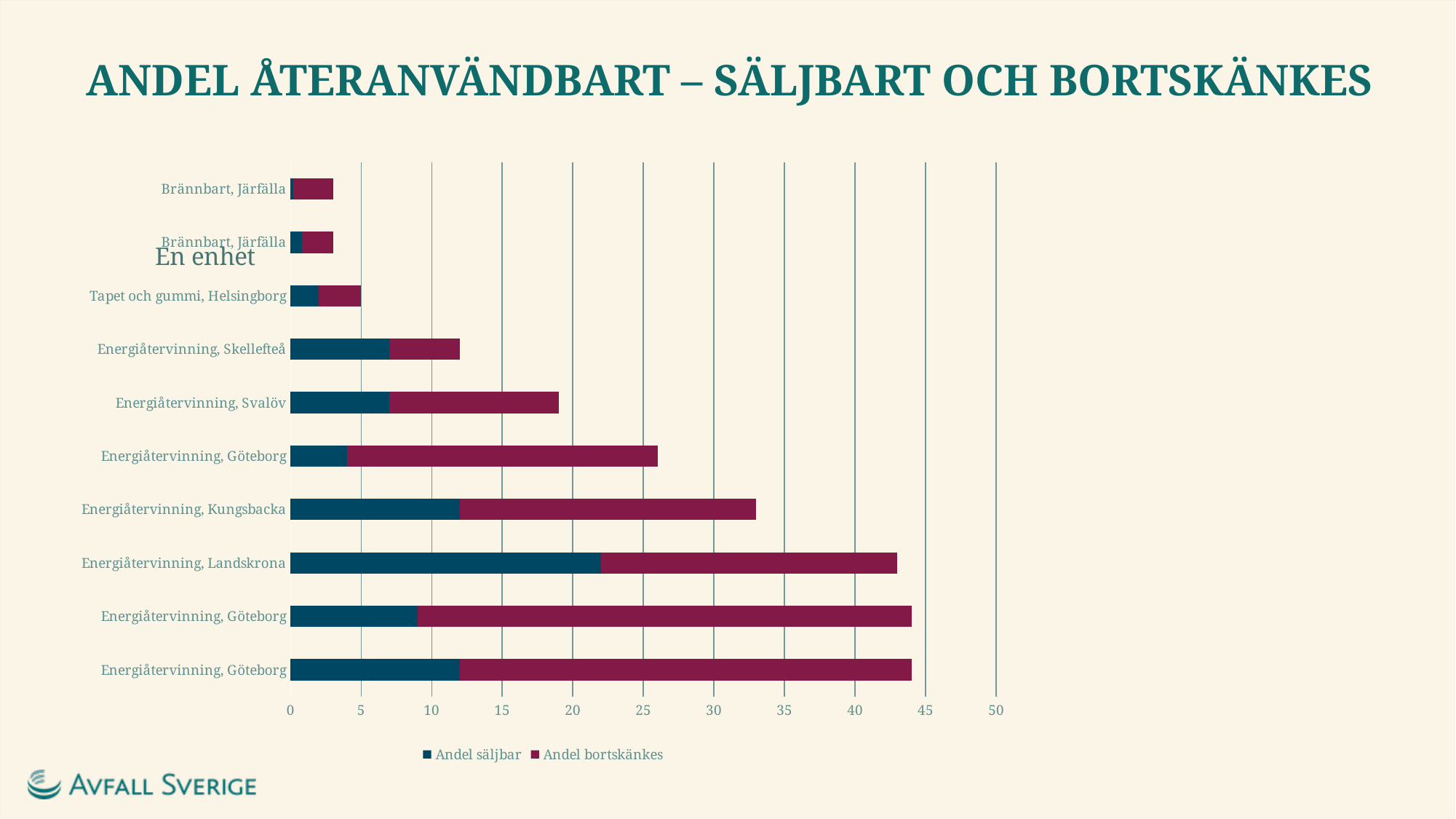
Is the total bar for Energiåtervinning, Landskrona greater or less than 40? greater Is the total bar for Energiåtervinning, Kungsbacka greater or less than 30? greater Is the total bar for Energiåtervinning, Skellefteå greater or less than 10? greater Which has the larger total bar, Energiåtervinning, Kungsbacka or Energiåtervinning, Svalöv? Energiåtervinning, Kungsbacka What kind of chart is shown on the slide? bar chart Which category has the shortest total bar? Brännbart, Järfälla What are the two series named in the legend? Andel säljbar and Andel bortskänkes Which has the larger total bar, Energiåtervinning, Landskrona or Energiåtervinning, Kungsbacka? Energiåtervinning, Landskrona How many series does the legend list? 2 Which category has the longest total bar? Energiåtervinning, Göteborg How many bars are plotted in the chart? 10